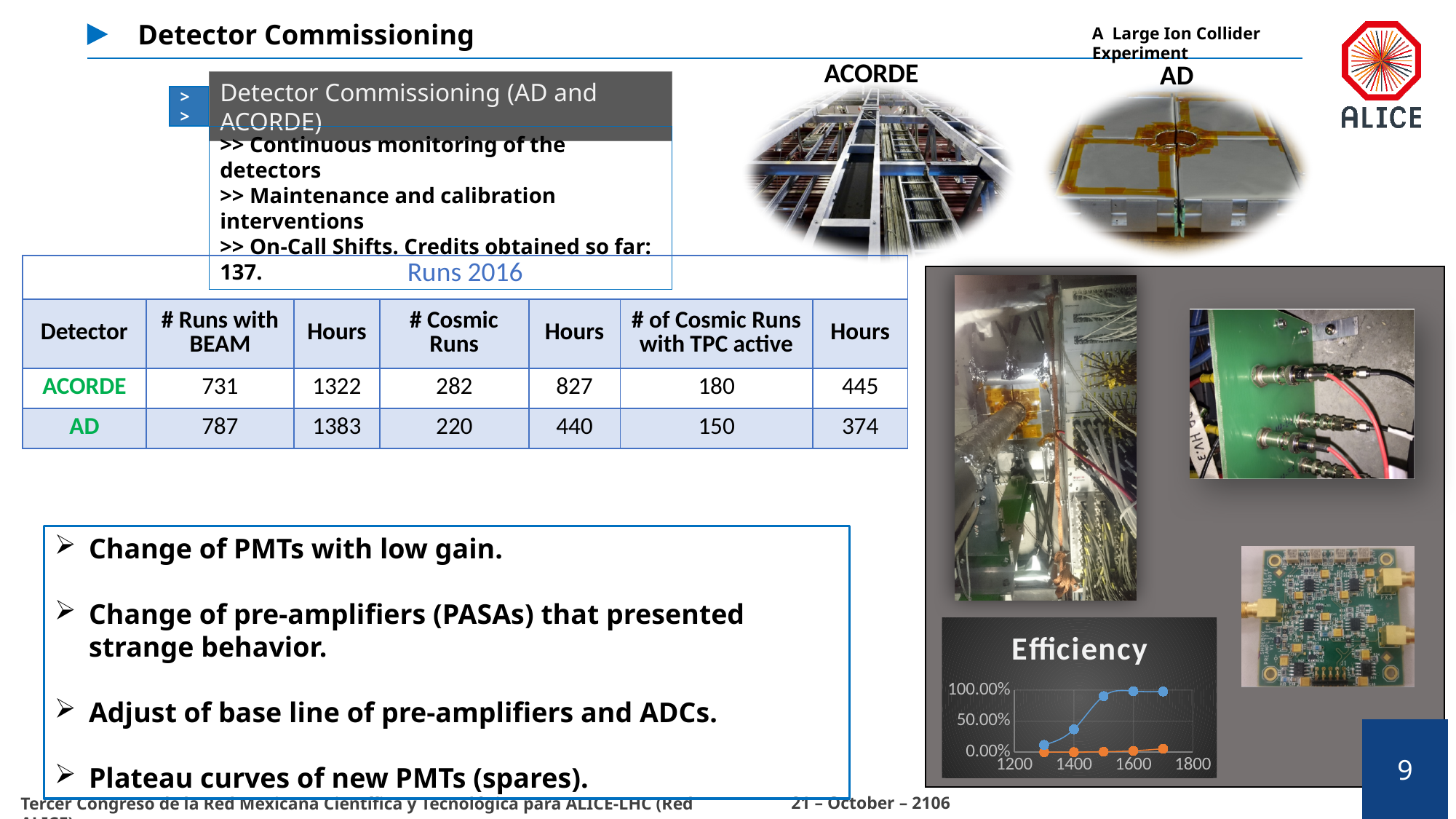
What is the highest tick label shown on the y-axis of the Efficiency chart? 100.00% How many data points does the blue series have in the Efficiency chart? 5 In the Efficiency chart, at which x-axis value does the blue series first exceed 50.00%? 1500 What is the title of the chart on the slide? Efficiency In the Efficiency chart, does the blue series rise or fall as the x-axis value increases from 1300 to 1700? rise In the Efficiency chart, is the value of the orange series at x = 1700 greater or less than 50.00%? less How many data series are plotted in the Efficiency chart? 2 What kind of chart is the Efficiency chart? line chart In the Efficiency chart, is the value of the blue series at x = 1300 greater or less than 50.00%? less In the Efficiency chart, which series has the larger value at x = 1600, the blue or the orange one? blue